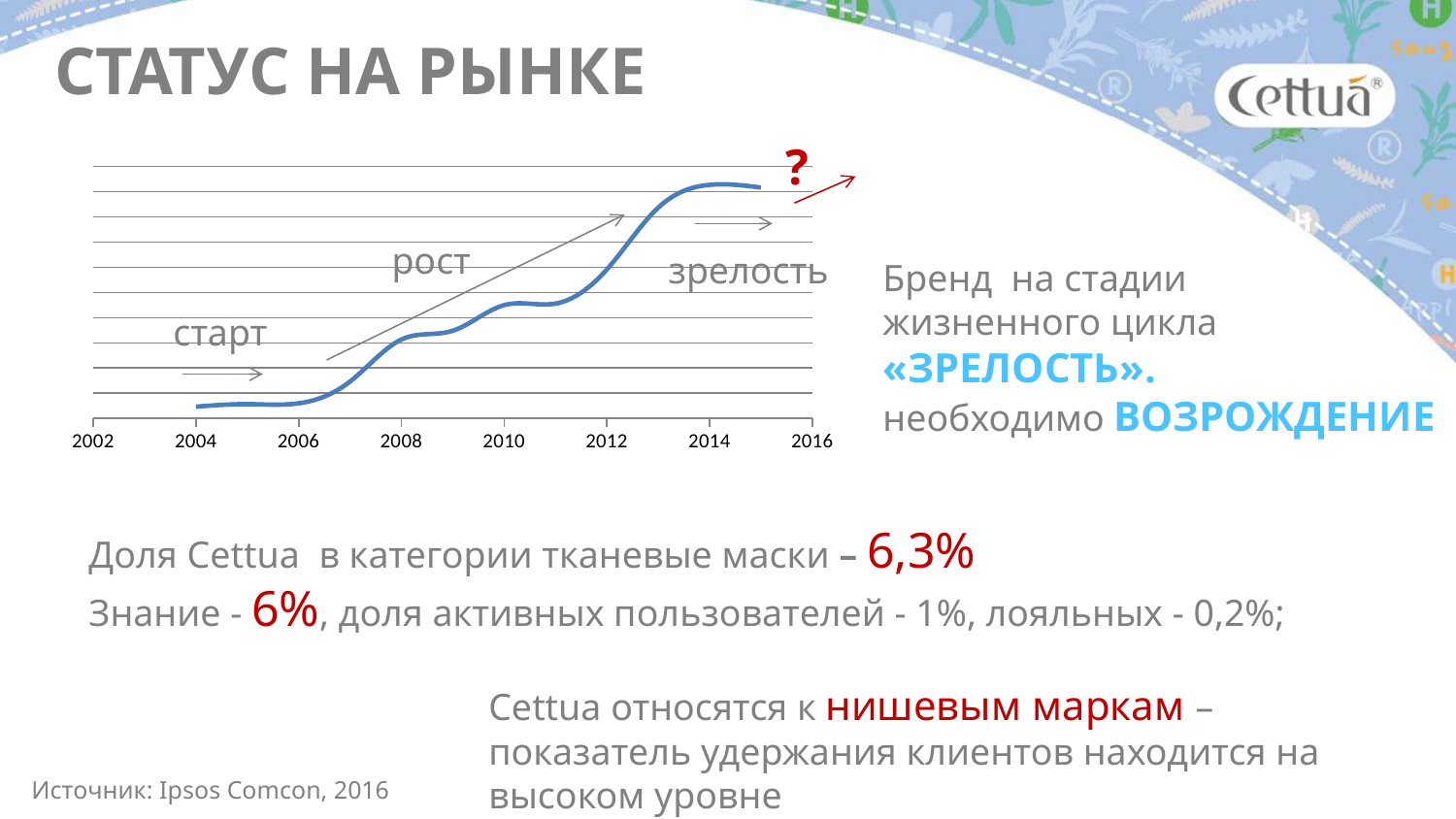
Which stage label appears at the right end of the chart, above the flat part of the line? зрелость What kind of chart is shown on the slide? line chart What is the last year label on the x axis of the chart? 2016 How many year labels are shown on the x axis of the chart? 8 Does the plotted line generally rise or fall from 2004 to 2014? rise How many lines are plotted on the chart? 1